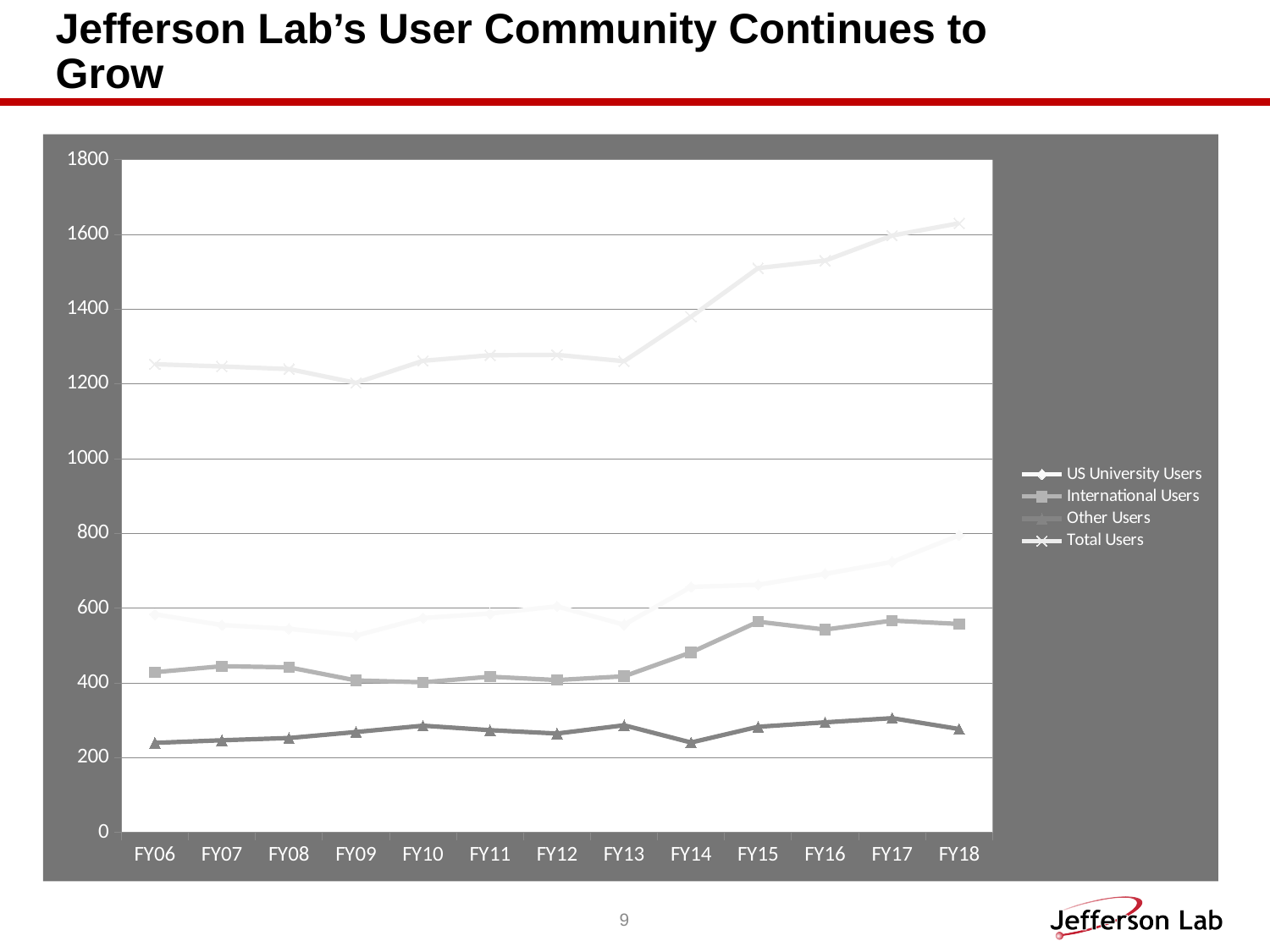
Do the Total Users values rise or fall from FY13 to FY18? rise In which fiscal year is the Total Users value highest? FY18 What kind of chart is shown on the slide? line chart Is the Total Users value for FY15 greater or less than 1400? greater Is the International Users value for FY15 greater or less than 400? greater Which series has the highest values across all fiscal years? Total Users In which fiscal year is the Total Users value lowest? FY09 Which is larger, the Total Users value for FY18 or for FY06? FY18 How many series does the legend list? 4 Is the Total Users value for FY13 greater or less than 1400? less How many fiscal years are plotted along the x axis? 13